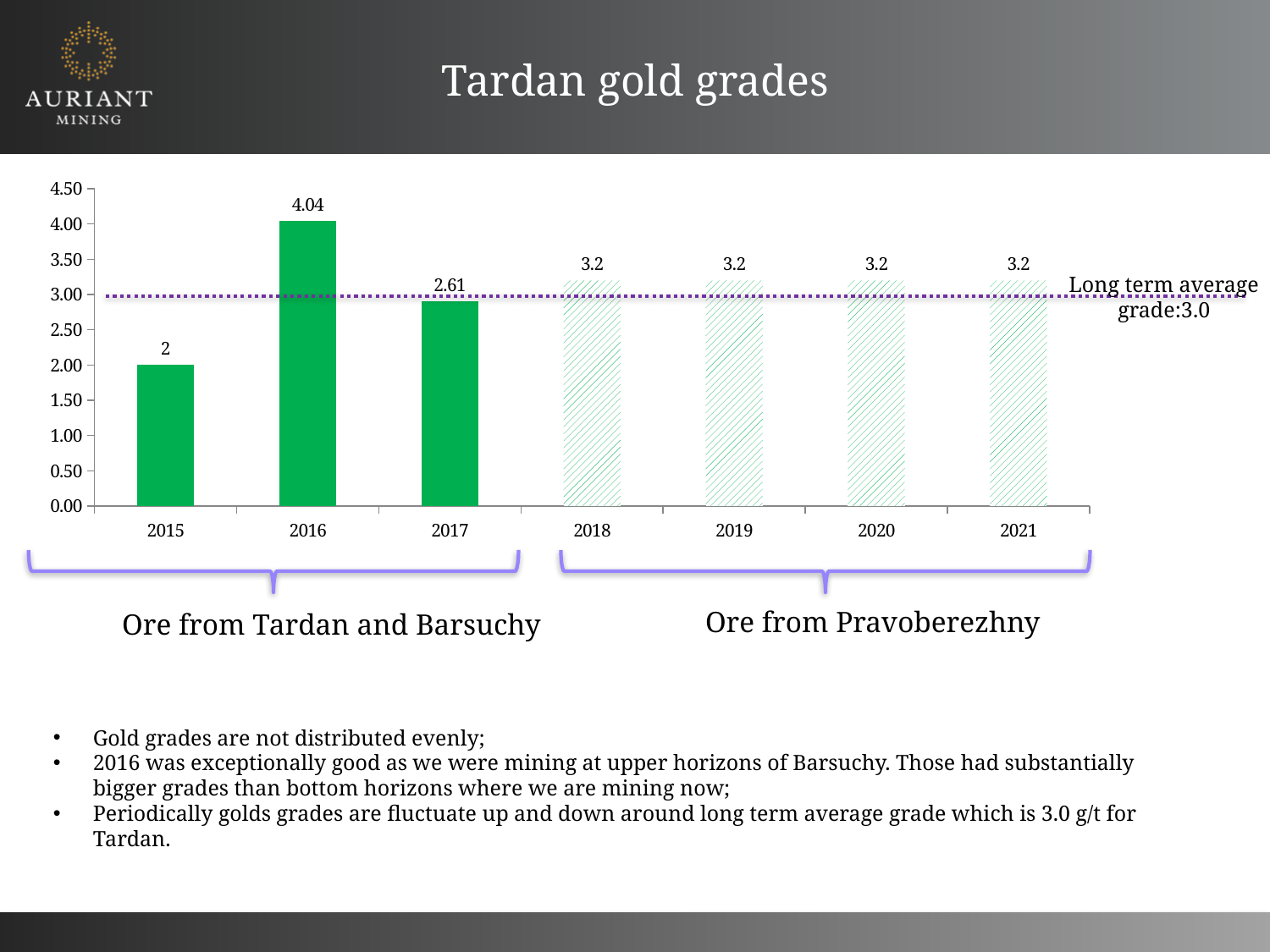
What is the gold grade shown for 2015? 2 What kind of chart is shown on the slide? Bar chart Which year has a higher gold grade, 2017 or 2018? 2018 What is the gold grade shown for 2019? 3.2 What is the gold grade shown for 2016? 4.04 What is the difference between the gold grades for 2016 and 2015? 2.04 Which year has the lowest gold grade? 2015 What is the gold grade shown for 2017? 2.61 Is the value for 2016 greater or less than 3.50? greater What long term average grade is marked by the dotted line? 3.0 How many years are shown on the x axis? 7 Which year has the highest gold grade? 2016